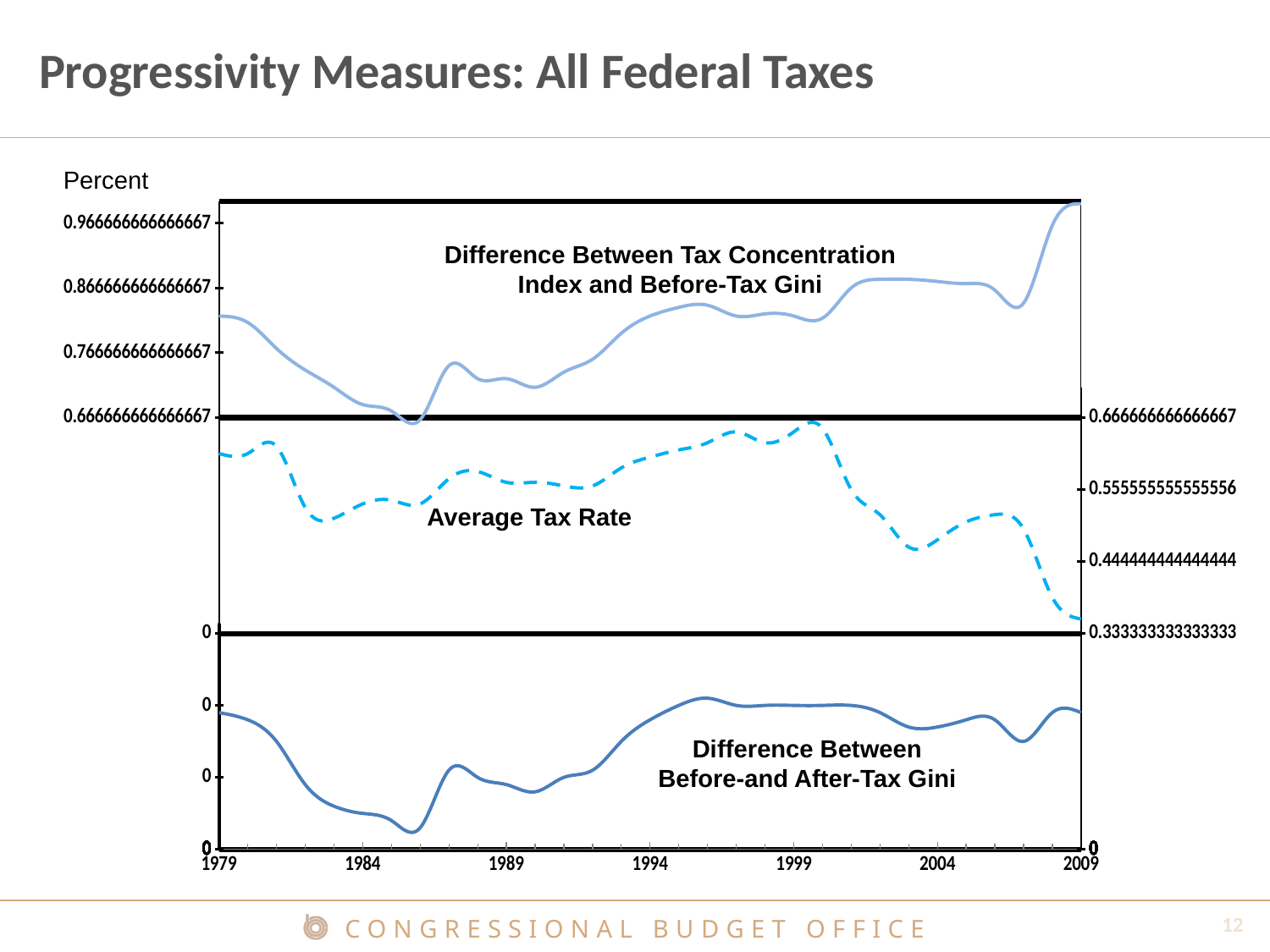
Is the Average Tax Rate higher in 1979 or in 2009? 1979 Does the Difference Between Before-and After-Tax Gini line rise or fall between 1986 and 1996? rise What is the title of the slide's chart? Progressivity Measures: All Federal Taxes How many year labels are printed along the x axis? 7 How many data series (lines) are plotted on the chart? 3 What kind of chart is shown on the slide? line chart Does the Average Tax Rate line rise or fall between 1999 and 2009? fall What is the first year shown on the x axis? 1979 Does the Difference Between Tax Concentration Index and Before-Tax Gini line rise or fall between 1979 and 1985? fall Which line on the chart is drawn as a dashed line? Average Tax Rate Is the Difference Between Tax Concentration Index and Before-Tax Gini higher in 1979 or in 2009? 2009 What is the last year shown on the x axis? 2009